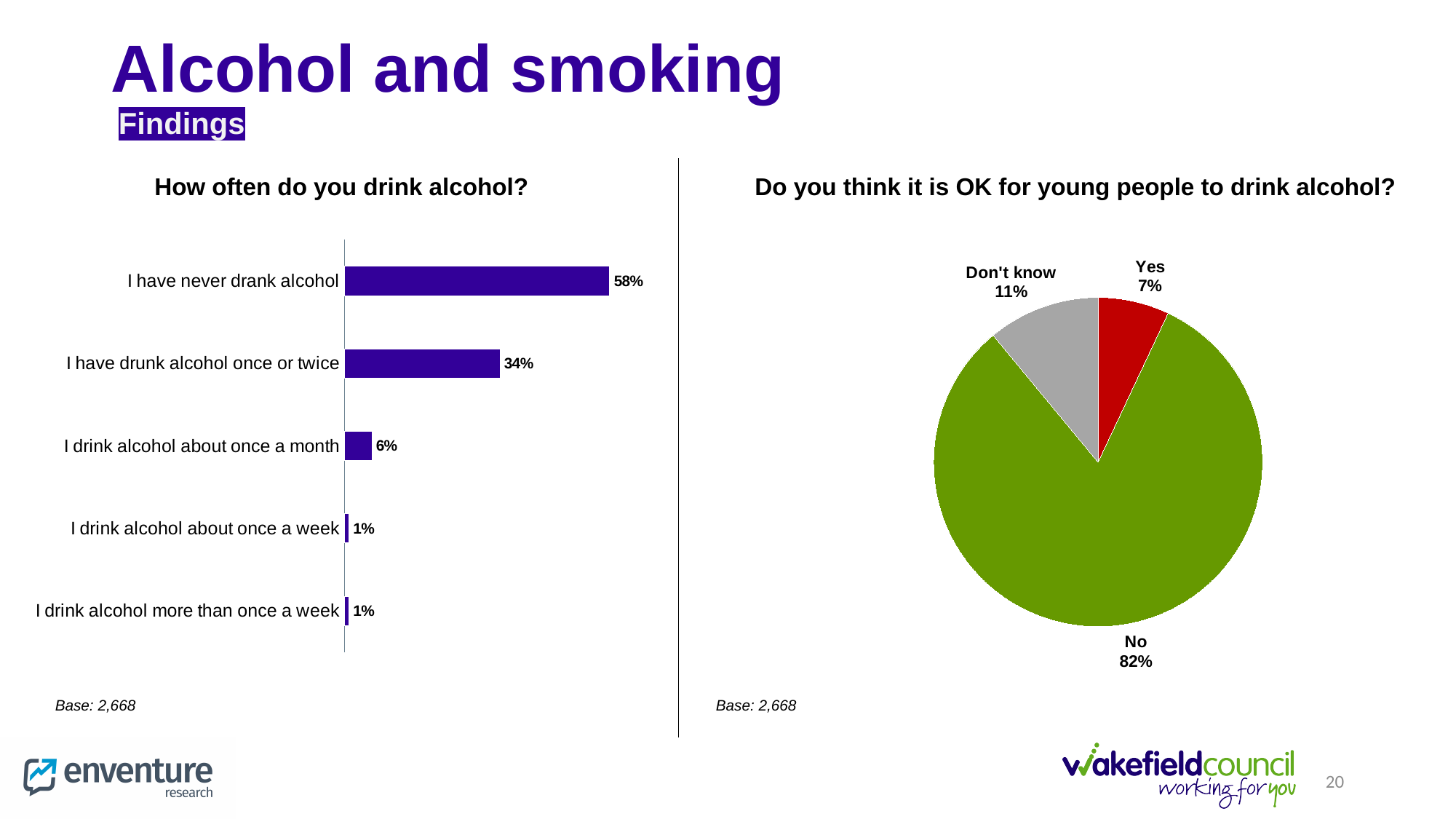
In the 'How often do you drink alcohol?' chart, what is the difference between 'I have never drank alcohol' and 'I have drunk alcohol once or twice'? 24% In the 'How often do you drink alcohol?' chart, what is the value for 'I have drunk alcohol once or twice'? 34% In the 'How often do you drink alcohol?' chart, which is larger: 'I drink alcohol about once a month' or 'I drink alcohol about once a week'? I drink alcohol about once a month What type of chart is 'Do you think it is OK for young people to drink alcohol?'? Pie chart What type of chart is 'How often do you drink alcohol?'? Bar chart In the 'How often do you drink alcohol?' chart, what percentage of respondents said they have never drank alcohol? 58% In the 'How often do you drink alcohol?' chart, which category has the highest value? I have never drank alcohol In the 'How often do you drink alcohol?' chart, how many categories are shown? 5 In the 'Do you think it is OK for young people to drink alcohol?' chart, what colour is the 'No' slice? Green In the 'Do you think it is OK for young people to drink alcohol?' chart, what percentage answered 'Don't know'? 11% In the 'Do you think it is OK for young people to drink alcohol?' chart, which response has the smallest slice? Yes In the 'Do you think it is OK for young people to drink alcohol?' chart, what share of respondents answered 'No'? 82%